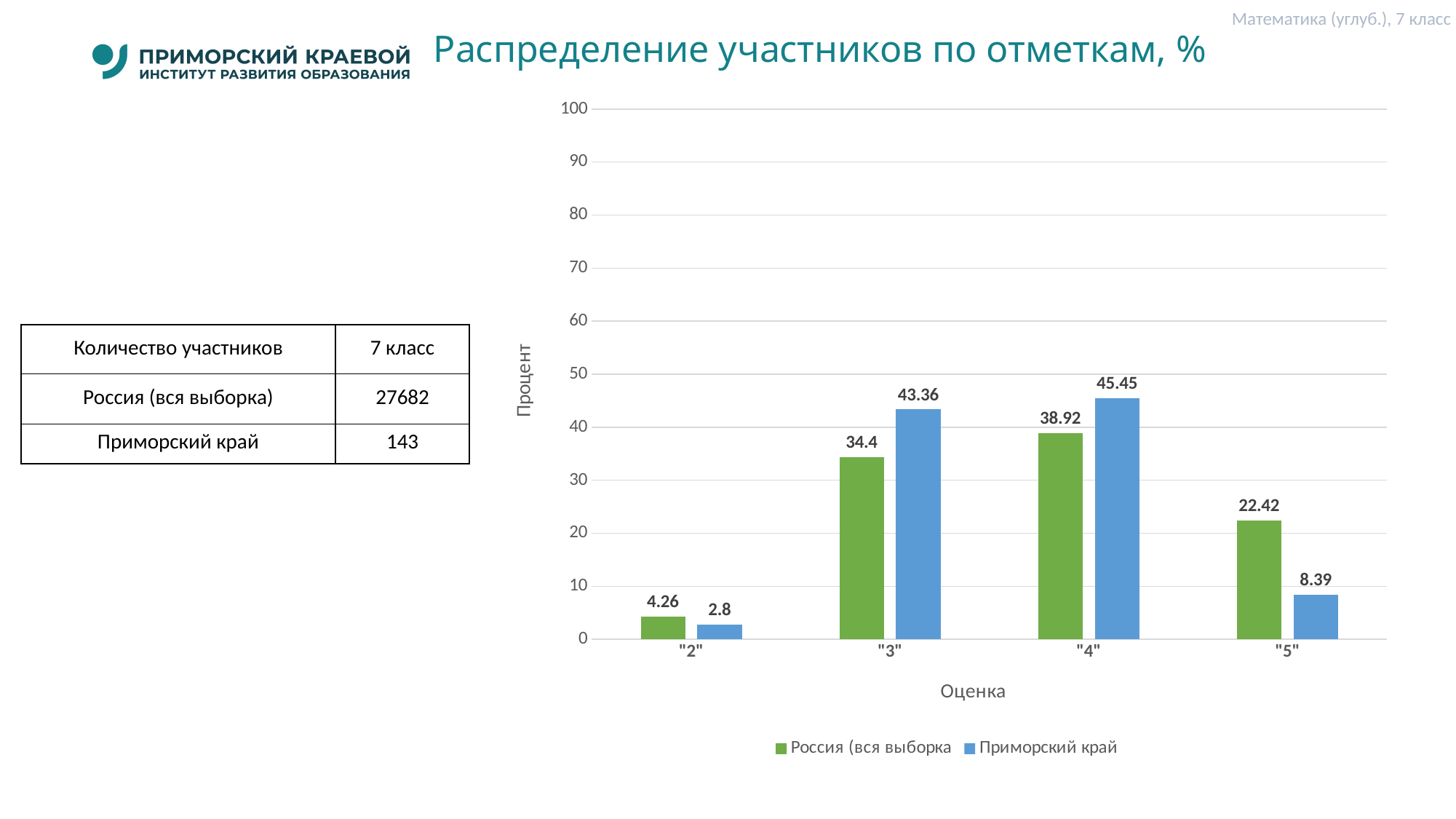
What is the value for Приморский край for grade "3"? 43.36 What is the value for Россия (вся выборка) for grade "5"? 22.42 What type of chart is shown on the slide? Bar chart For which grade is the value for Россия (вся выборка) lowest? "2" How many series does the legend list? 2 Which is larger for grade "5": Россия (вся выборка) or Приморский край? Россия (вся выборка) How many grade categories are shown on the x axis? 4 For which grade is the value for Приморский край highest? "4" What is the label of the y axis? Процент What is the difference between the Приморский край and Россия (вся выборка) values for grade "3"? 8.96 What is the value for Приморский край for grade "2"? 2.8 Is the value for Приморский край for grade "4" greater or less than 40? greater